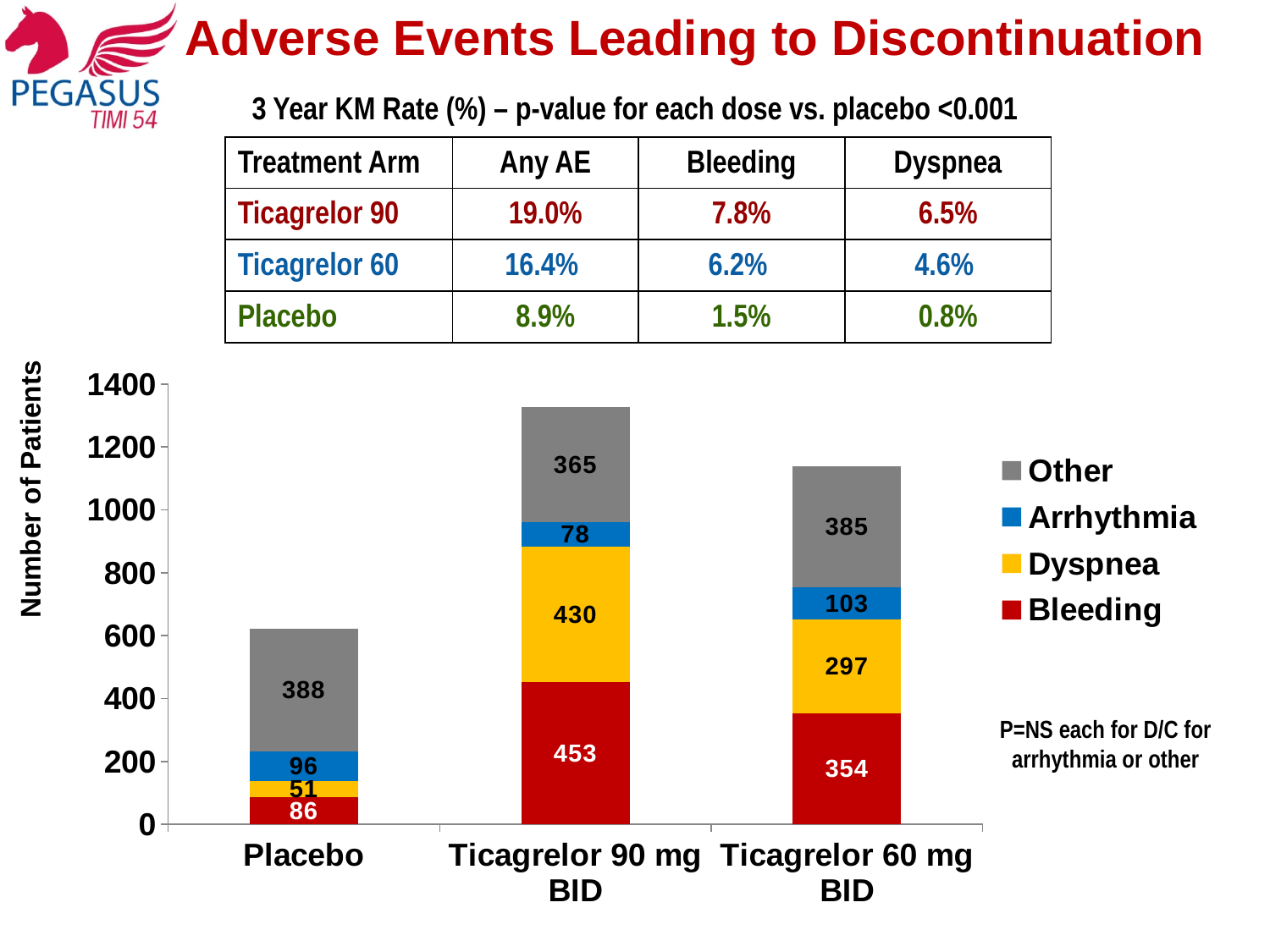
Which treatment arm has the lowest number of patients discontinuing for Bleeding? Placebo How many treatment arms are plotted on the x axis of the chart? 3 Which is larger: the number of patients discontinuing for Dyspnea in the Ticagrelor 90 mg BID arm or in the Ticagrelor 60 mg BID arm? Ticagrelor 90 mg BID What is the label of the y axis of the chart? Number of Patients What is the number of patients discontinuing for Bleeding in the Ticagrelor 90 mg BID arm? 453 What is the number of patients discontinuing for Dyspnea in the Ticagrelor 60 mg BID arm? 297 What type of chart is shown on the slide? Stacked bar chart What is the number of patients discontinuing for Arrhythmia in the Placebo arm? 96 Which treatment arm has the highest number of patients discontinuing for Other reasons? Placebo What is the difference in the number of patients discontinuing for Bleeding between Ticagrelor 90 mg BID and Ticagrelor 60 mg BID? 99 How many series does the chart legend list? 4 What is the total number of patients in the Ticagrelor 90 mg BID stacked bar? 1326